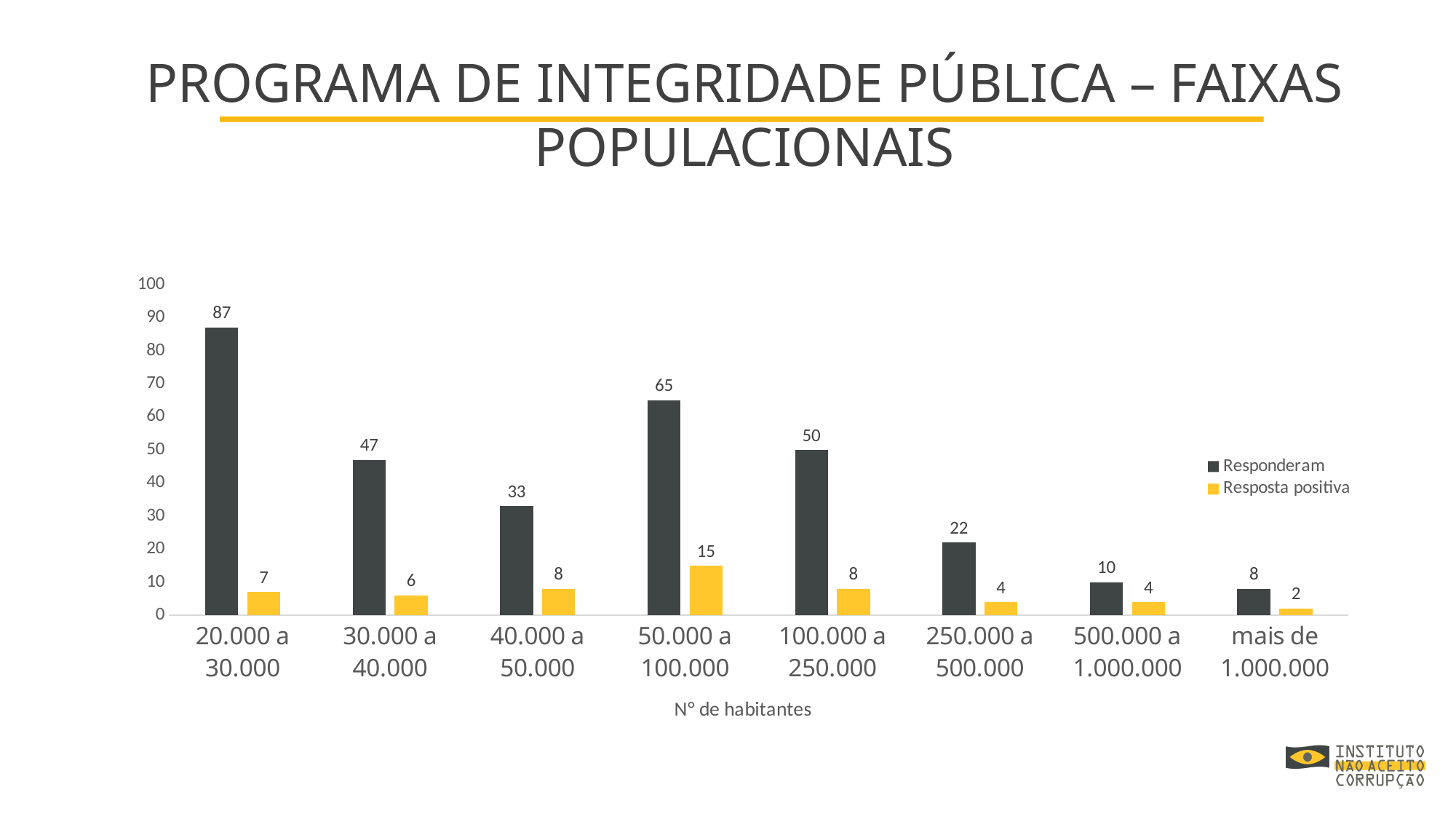
How many population categories are shown on the x axis? 8 What is the value of Resposta positiva for the 50.000 a 100.000 category? 15 Which category has the highest Responderam value? 20.000 a 30.000 Is the Responderam value for 250.000 a 500.000 greater or less than 30? less What is the label of the x axis? N° de habitantes What is the difference between Responderam and Resposta positiva for the 100.000 a 250.000 category? 42 What kind of chart is shown on the slide? bar chart What is the value of Responderam for the 20.000 a 30.000 category? 87 What is the value of Responderam for the mais de 1.000.000 category? 8 How many series does the legend list? 2 Which category has the lowest Resposta positiva value? mais de 1.000.000 Which is larger: Responderam for 30.000 a 40.000 or Responderam for 50.000 a 100.000? 50.000 a 100.000